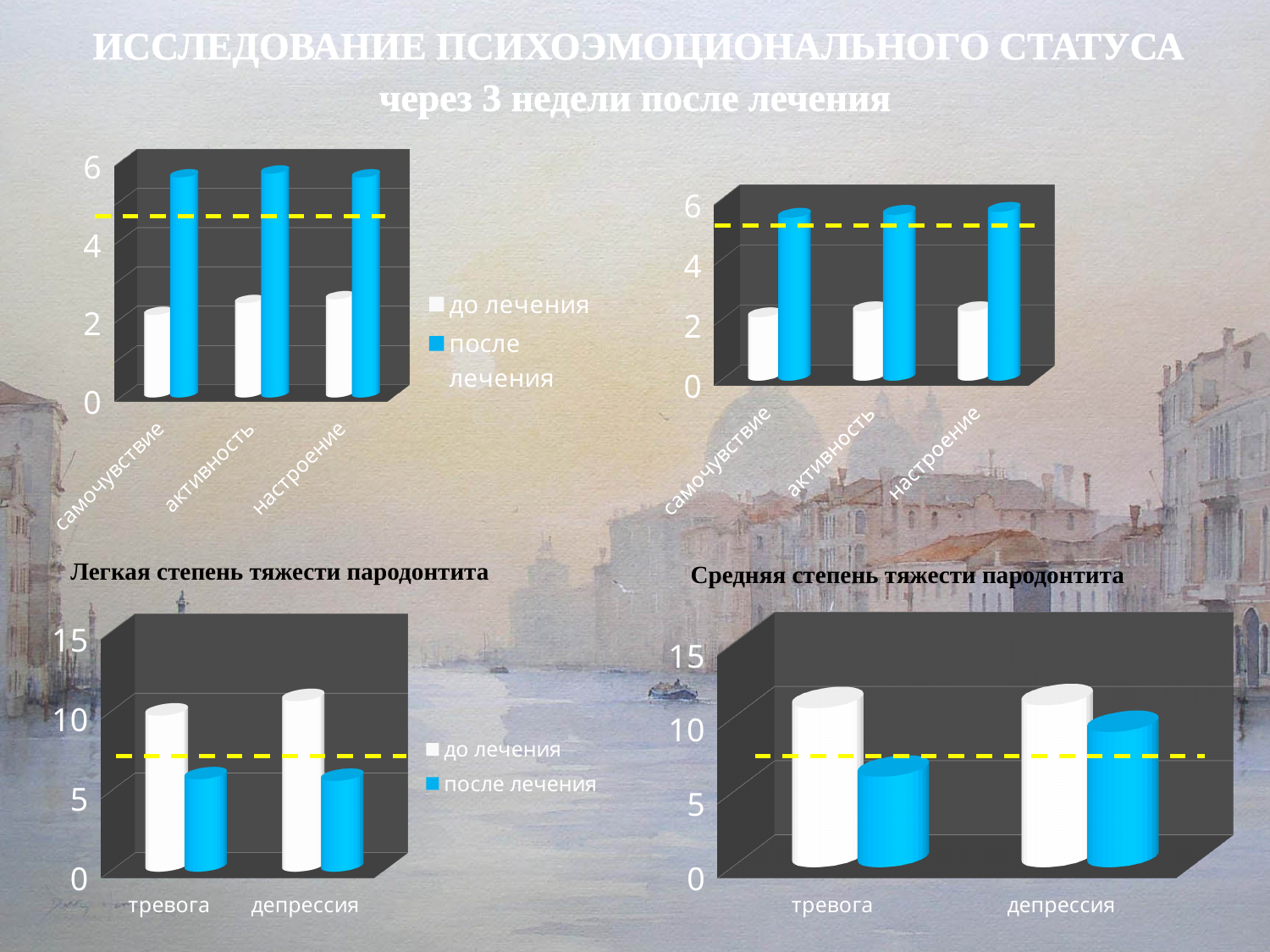
In the top-left chart, is the value for после лечения for самочувствие greater or less than 4? greater What kind of chart is the top-left chart on the slide? bar chart In the top-left chart, is the value for до лечения for самочувствие greater or less than 4? less In the bottom-left chart, which series has the larger value for депрессия, до лечения or после лечения? до лечения How many categories does the top-left chart show on its x axis? 3 In the bottom-left chart, is the value for до лечения for тревога greater or less than 5? greater How many categories does the bottom-left chart show on its x axis? 2 How many series does the legend of the top-left chart list? 2 What are the two legend entries of the bottom-left chart? до лечения, после лечения In the top-left chart, which series has the larger value for активность, до лечения or после лечения? после лечения